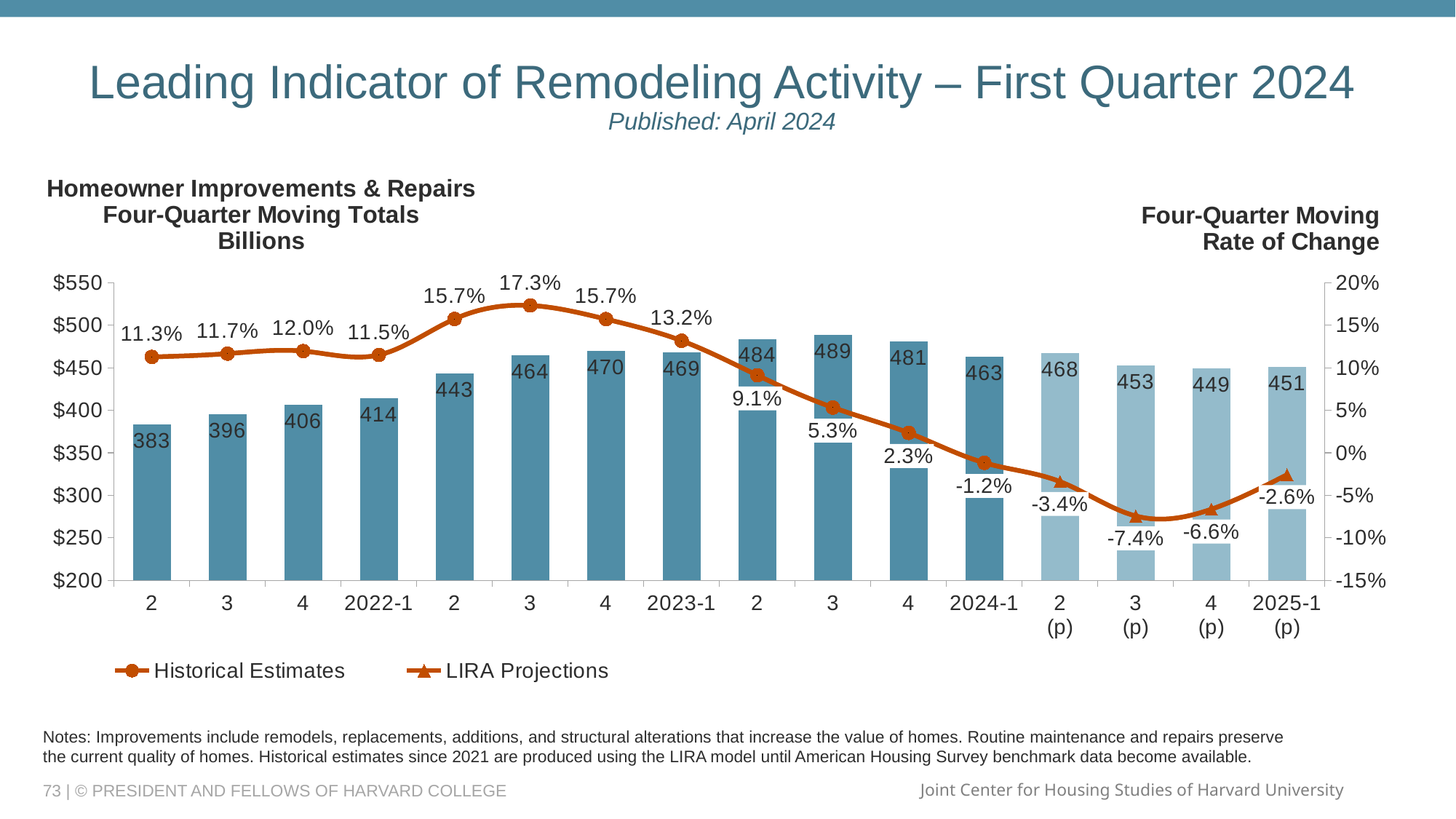
What is the highest four-quarter moving rate of change shown on the line? 17.3% Do the four-quarter moving totals rise or fall from 2021 quarter 2 through 2023-3? Rise Which is larger, the four-quarter moving total for 2024-1 or for 2024-2 (p)? 2024-2 (p) What is the four-quarter moving rate of change for 2025-1 (p)? -2.6% Which quarter has the highest four-quarter moving total? 2023-3 (489) Which quarter has the lowest four-quarter moving rate of change? 2024-3 (p), at -7.4% What kind of chart is this? A combination bar and line chart What is the difference between the highest bar (489) and the lowest bar (383)? 106 Which quarter has the lowest four-quarter moving total? 2021 quarter 2 (383) How many quarters are plotted along the x axis? 16 What is the four-quarter moving total for 2023-3? 489 How many series does the legend list? 2